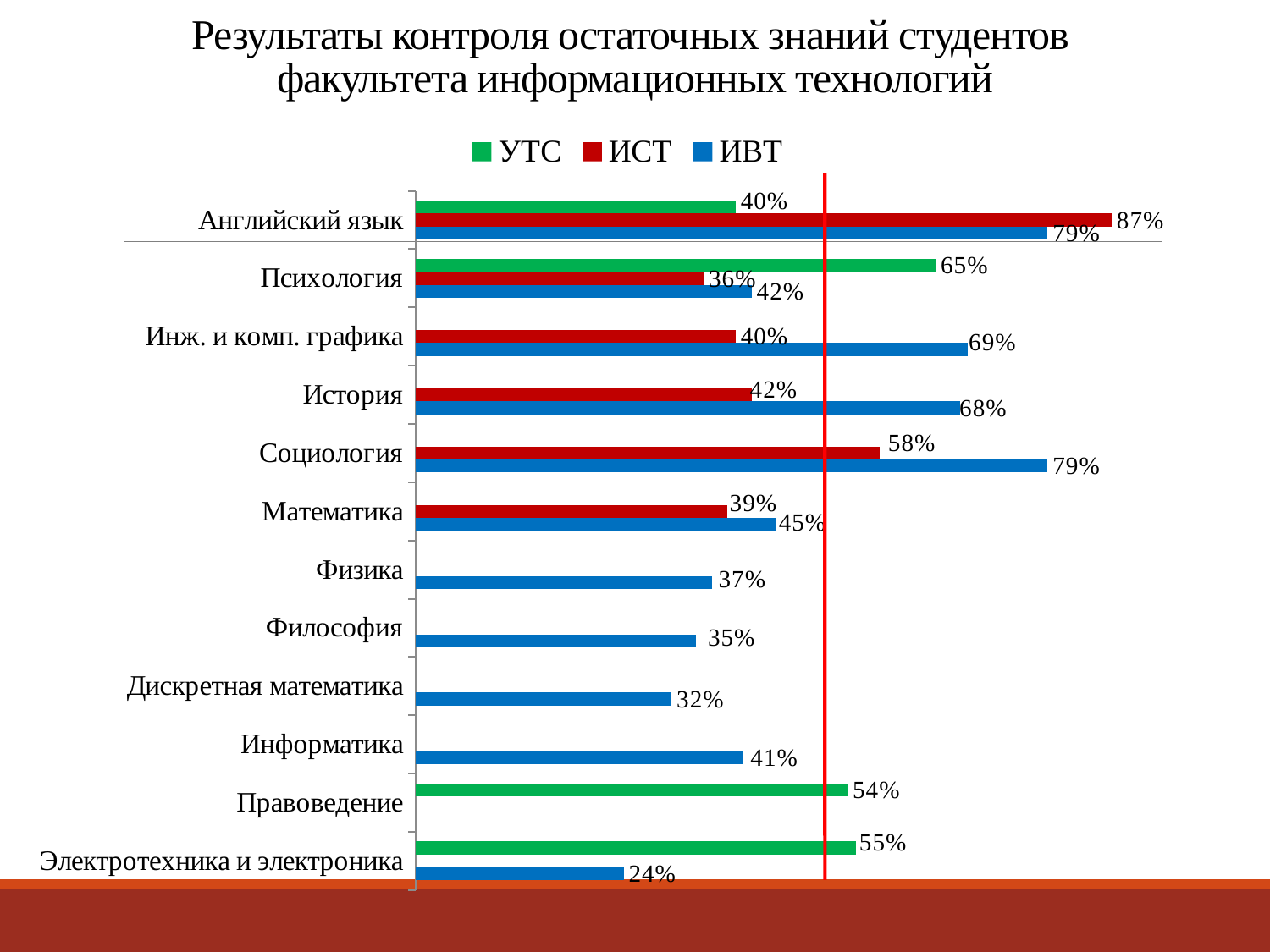
Which colour represents the ИВТ series in the legend? blue How many series does the legend list? 3 Which subject has the highest ИСТ value? Английский язык What is the value for ИСТ in Английский язык? 87% What is the difference between the ИВТ and ИСТ values for Инж. и комп. графика? 29% What is the value for ИВТ in Дискретная математика? 32% How many categories (subjects) are shown on the chart? 12 What kind of chart is shown on the slide? bar chart What is the value for УТС in Психология? 65% What is the difference between the УТС and ИВТ values for Электротехника и электроника? 31% Which subject has the lowest ИВТ value? Электротехника и электроника Which is larger for Социология: the ИСТ value or the ИВТ value? ИВТ